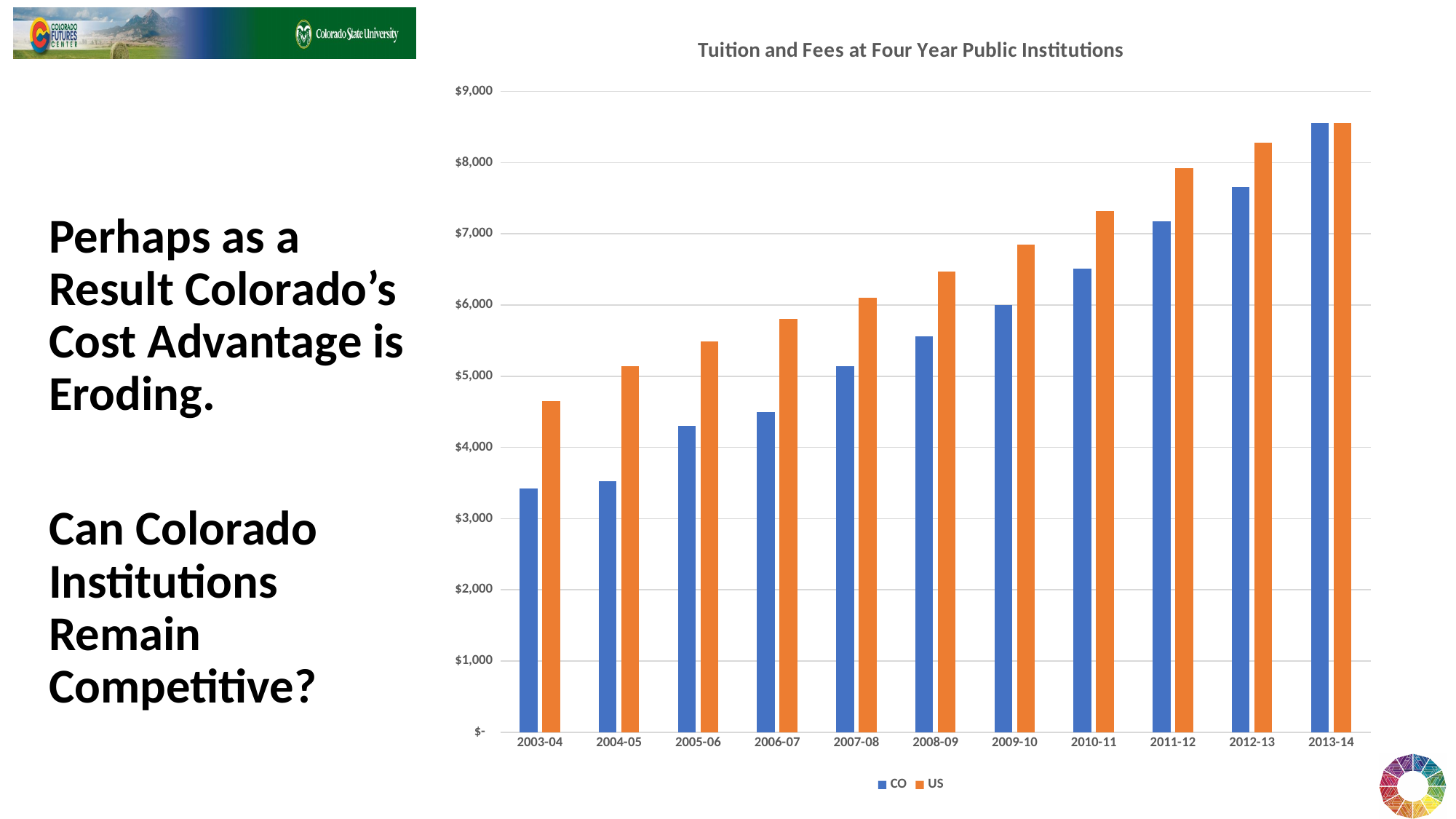
Do the CO values rise or fall from 2003-04 to 2013-14? Rise Is the value for CO in 2010-11 greater or less than $7,000? less Which series is shown in orange? US Is the value for US in 2012-13 greater or less than $8,000? greater How many series does the legend list? 2 What is the title of the chart? Tuition and Fees at Four Year Public Institutions In which year is the US value lowest? 2003-04 Is the value for US in 2003-04 greater or less than $4,000? greater What kind of chart is shown on the slide? Bar chart In which year is the CO value highest? 2013-14 How many academic years are shown on the x axis? 11